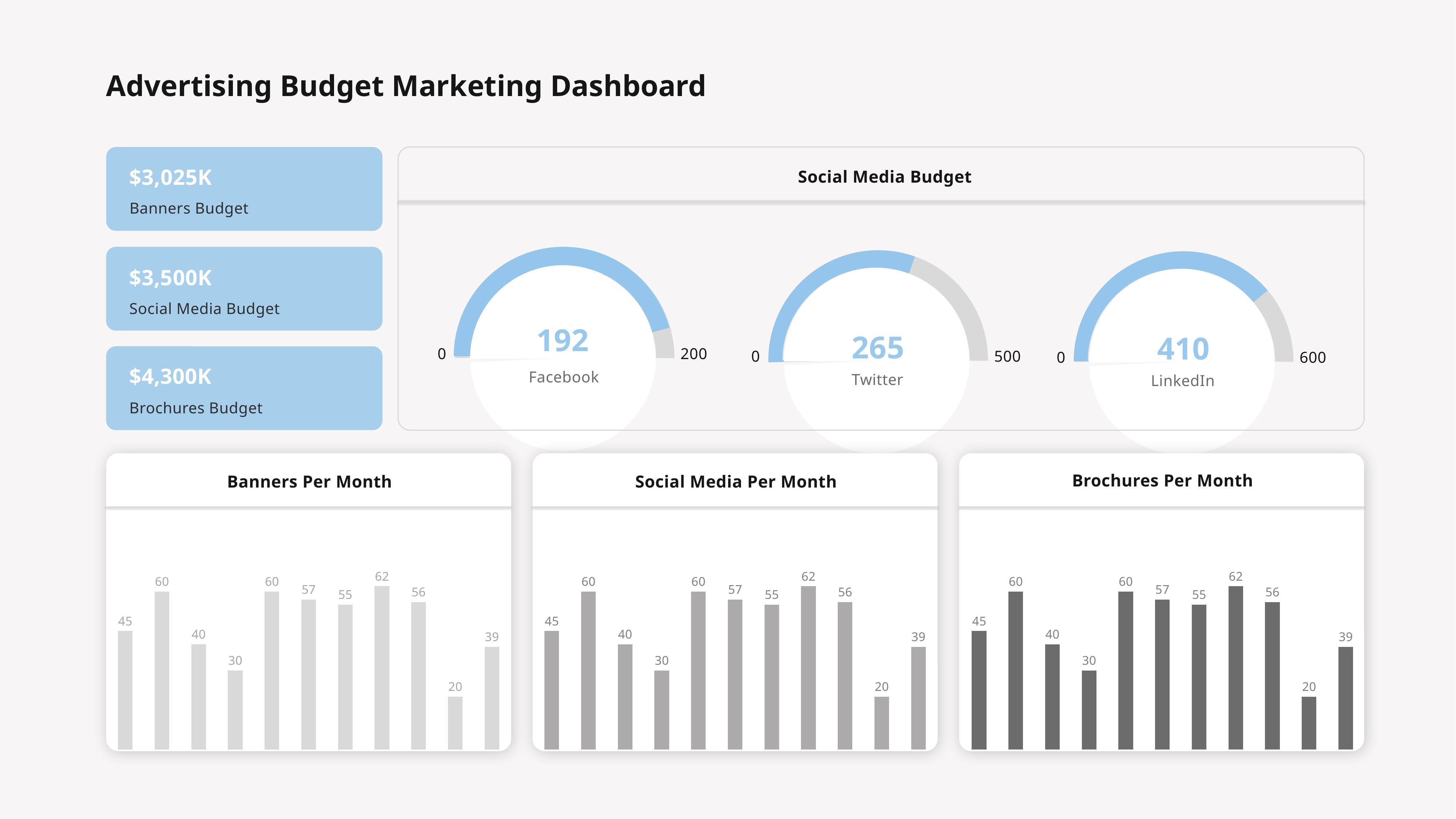
In the Social Media Budget gauges, what value is shown for Facebook? 192 In the Social Media Budget gauges, which platform has the lowest value? Facebook In the Social Media Budget gauges, which platform has the highest value? LinkedIn In the Banners Per Month chart, what is the difference between the highest bar value and the lowest bar value? 42 In the Social Media Budget gauges, what is the maximum value on the Twitter gauge scale? 500 What type of chart is the Brochures Per Month chart? Bar chart In the Social Media Budget gauges, what is the difference between the LinkedIn value and the Twitter value? 145 In the Banners Per Month chart, how many bars are plotted? 11 In the Brochures Per Month chart, what is the lowest value shown on a bar? 20 In the Social Media Budget gauges, what value is shown for Twitter? 265 In the Social Media Budget gauges, what value is shown for LinkedIn? 410 In the Social Media Per Month chart, what is the highest value shown on a bar? 62